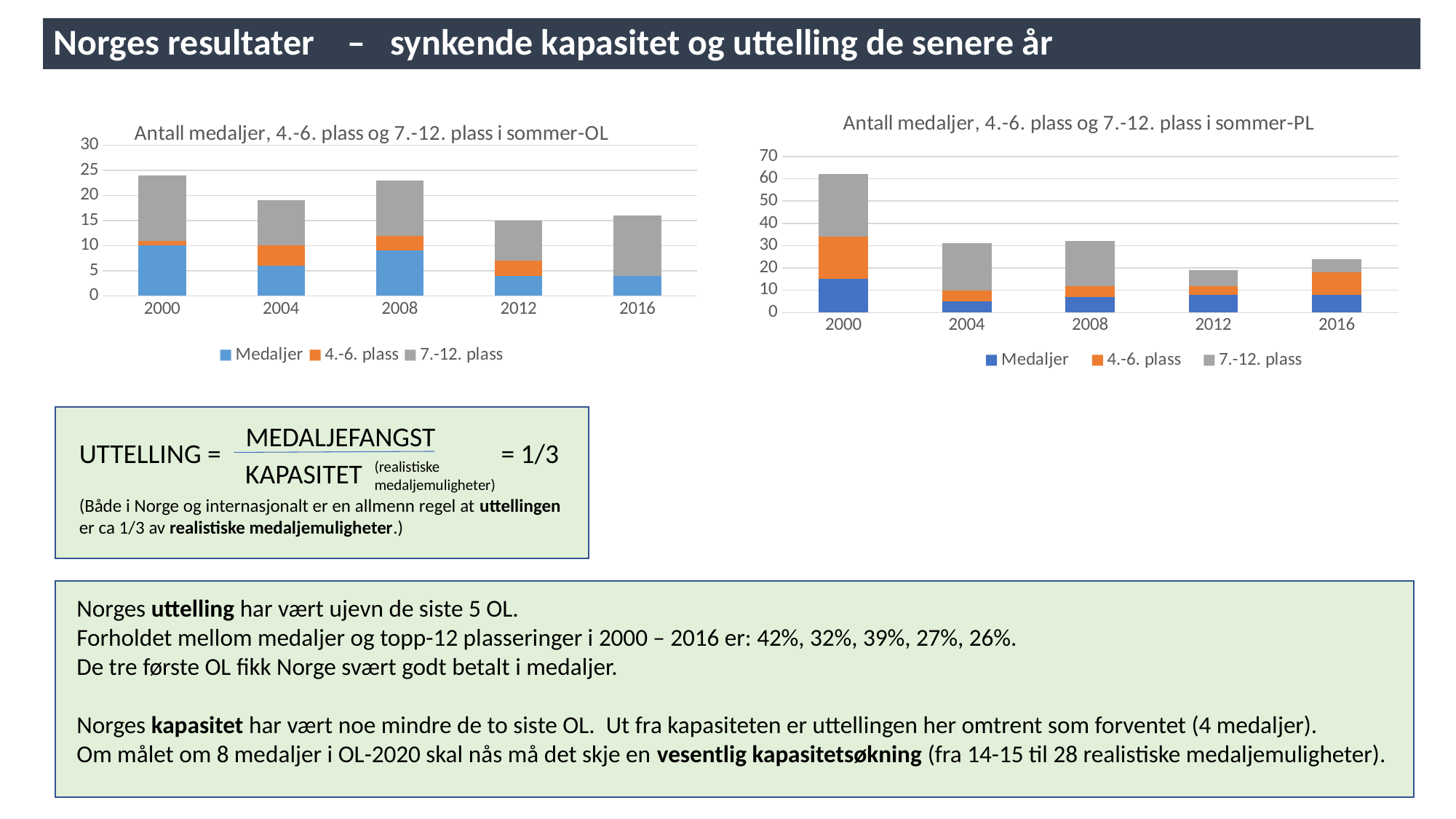
In the left chart (sommer-OL), is the total height of the 2000 bar greater or less than 20? greater In the left chart (sommer-OL), is the total height of the 2012 bar greater or less than 20? less What are the three legend entries in the right chart (sommer-PL)? Medaljer, 4.-6. plass, 7.-12. plass In the left chart (sommer-OL), which year has a larger Medaljer segment, 2000 or 2016? 2000 In the right chart (sommer-PL), is the total height of the 2000 bar greater or less than 50? greater In the right chart (sommer-PL), which year has a larger Medaljer segment, 2000 or 2004? 2000 In the left chart (sommer-OL), how many years are shown on the x axis? 5 In the left chart (sommer-OL), how many series does the legend list? 3 In the right chart (sommer-PL), which year has the highest total bar? 2000 What kind of chart is the left chart titled 'Antall medaljer, 4.-6. plass og 7.-12. plass i sommer-OL'? Stacked bar chart In the right chart (sommer-PL), which year has the lowest total bar? 2012